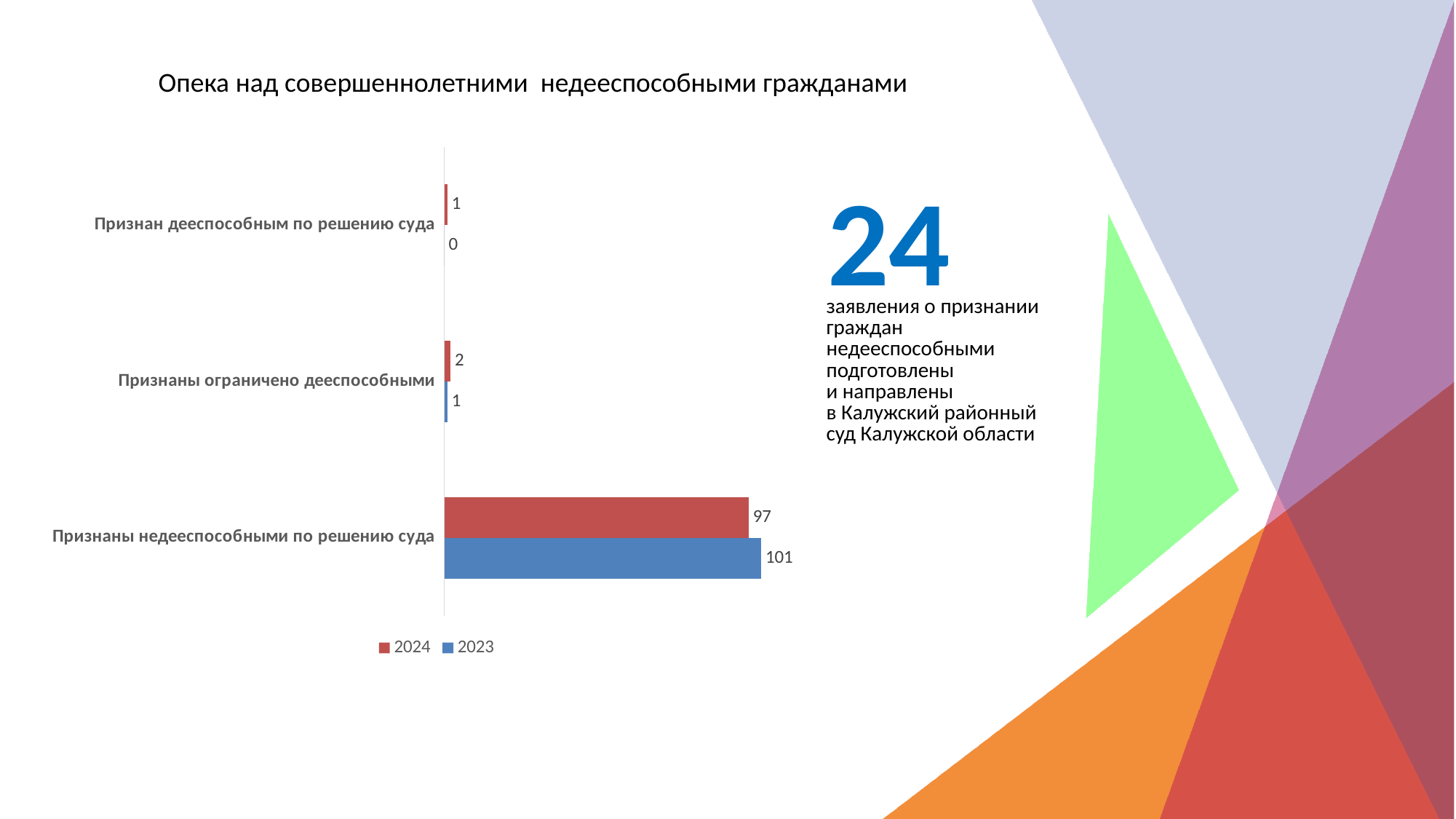
What kind of chart is shown on the slide? Bar chart How many series does the legend list? 2 What is the 2024 value for "Признаны недееспособными по решению суда"? 97 What is the 2024 value for "Признаны ограничено дееспособными"? 2 How many categories are shown in the chart? 3 Which colour represents the 2024 series in the chart? Red What is the 2023 value for "Признаны недееспособными по решению суда"? 101 Which category has the highest 2024 value? Признаны недееспособными по решению суда What is the 2023 value for "Признан дееспособным по решению суда"? 0 What is the difference between the 2023 and 2024 values for "Признаны недееспособными по решению суда"? 4 Which category has the lowest 2023 value? Признан дееспособным по решению суда For "Признаны недееспособными по решению суда", which year has the larger value, 2023 or 2024? 2023